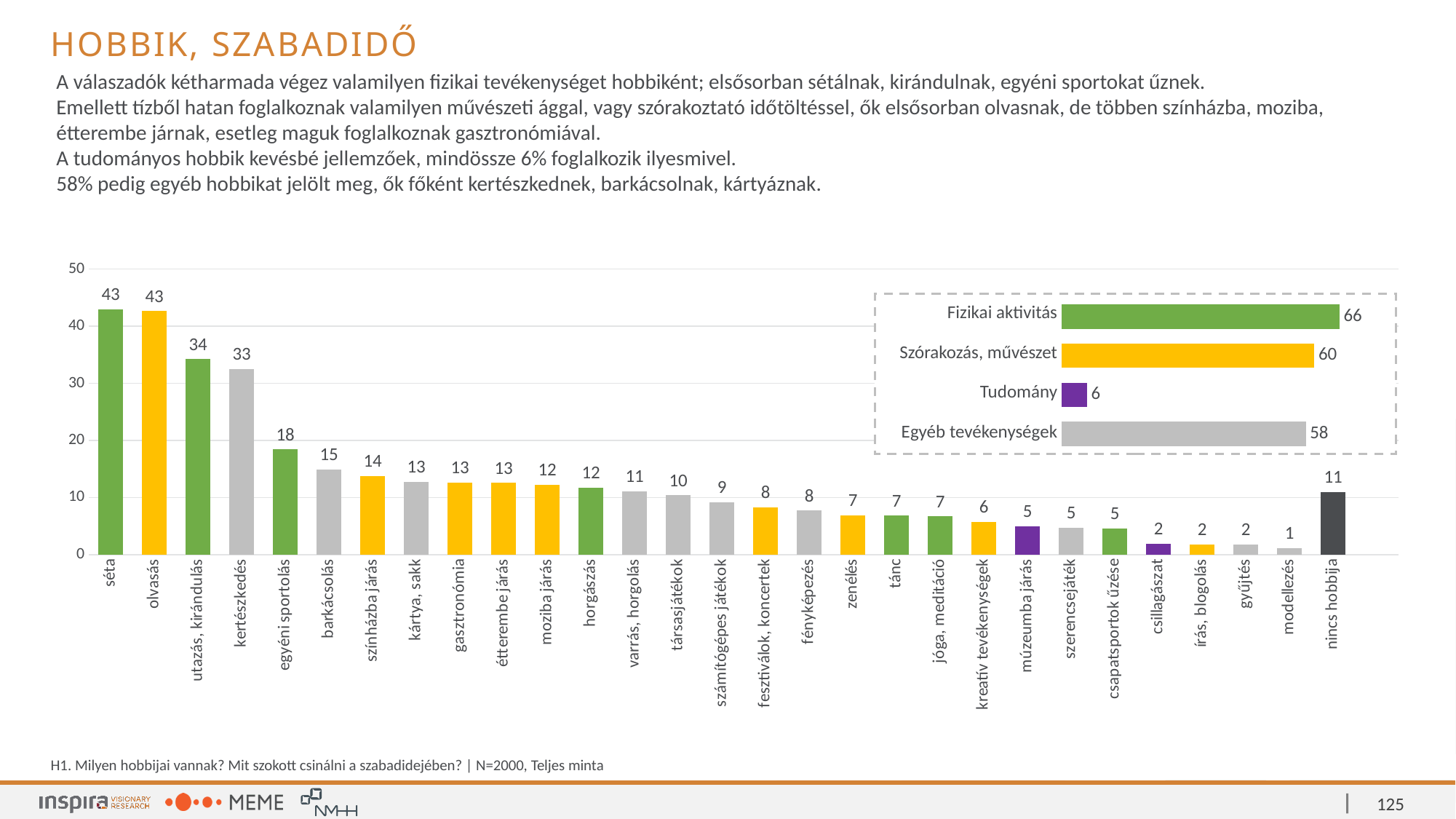
In the large bar chart, what is the value for kertészkedés? 33 In the inset chart in the top right, which category has the highest value? Fizikai aktivitás How many categories are shown in the inset chart in the top right? 4 In the large bar chart, which is larger, the value for barkácsolás or the value for társasjátékok? barkácsolás In the inset chart in the top right, what is the difference between Fizikai aktivitás and Egyéb tevékenységek? 8 How many categories are shown in the large bar chart? 29 In the large bar chart, what is the difference between the values for utazás, kirándulás and egyéni sportolás? 16 In the inset chart in the top right, what is the value for Tudomány? 6 In the large bar chart, what is the value for horgászás? 12 In the large bar chart, what is the value for nincs hobbija? 11 What kind of chart is the large chart on the slide? bar chart In the large bar chart, which category has the lowest value? modellezés